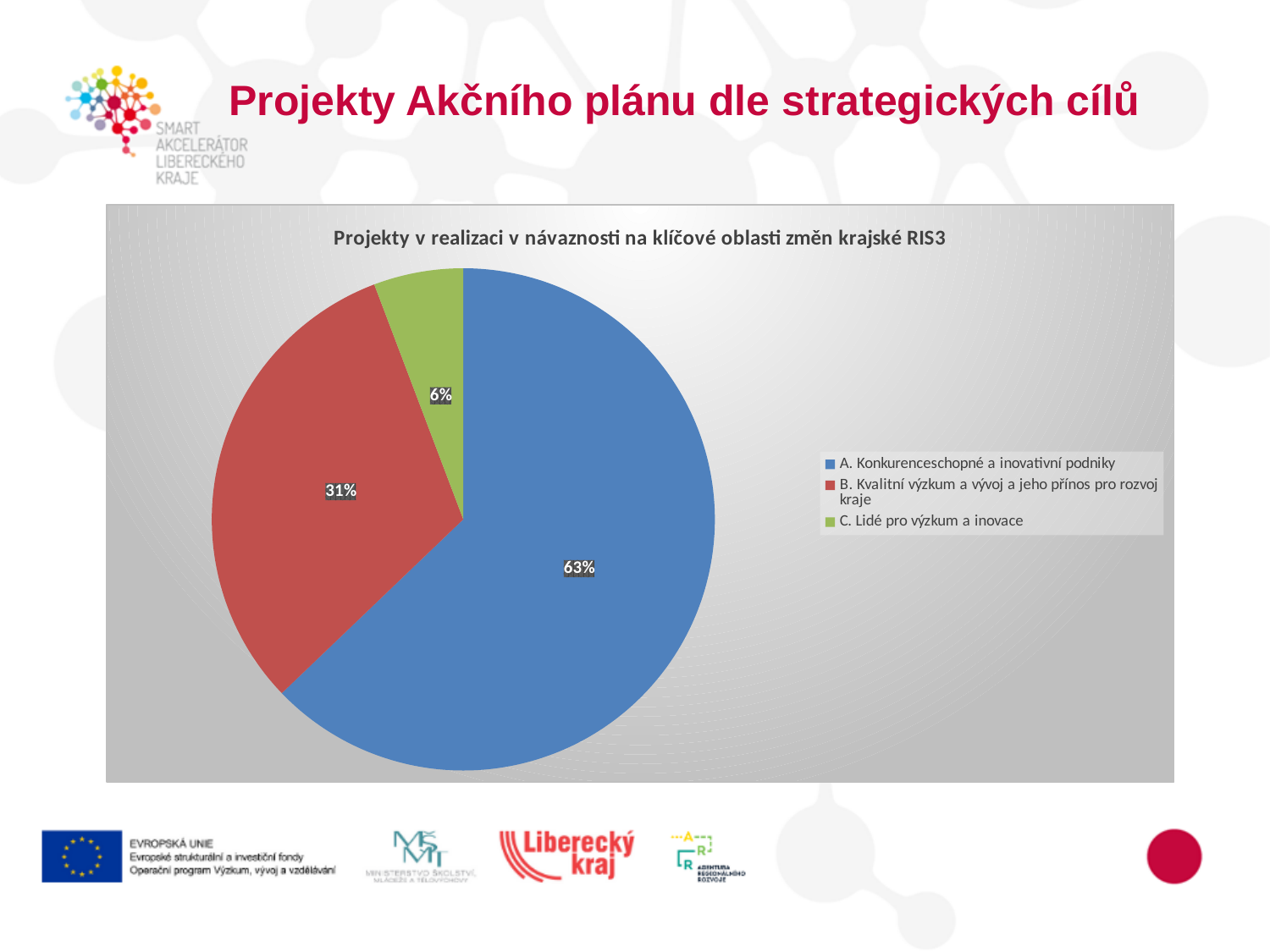
What kind of chart is shown on the slide? pie chart Which is larger, the share of category B or the share of category C? B. Kvalitní výzkum a vývoj a jeho přínos pro rozvoj kraje What share of the pie does 'A. Konkurenceschopné a inovativní podniky' have? 63% What colour is the slice for 'C. Lidé pro výzkum a inovace'? green Which category has the largest slice of the pie? A. Konkurenceschopné a inovativní podniky What is the chart's title? Projekty v realizaci v návaznosti na klíčové oblasti změn krajské RIS3 What is the difference in percentage points between the shares of category B and category C? 25 What is the difference in percentage points between the shares of category A and category B? 32 What share of the pie does 'C. Lidé pro výzkum a inovace' have? 6% Which category has the smallest slice of the pie? C. Lidé pro výzkum a inovace What share of the pie does 'B. Kvalitní výzkum a vývoj a jeho přínos pro rozvoj kraje' have? 31% How many categories does the pie chart show? 3